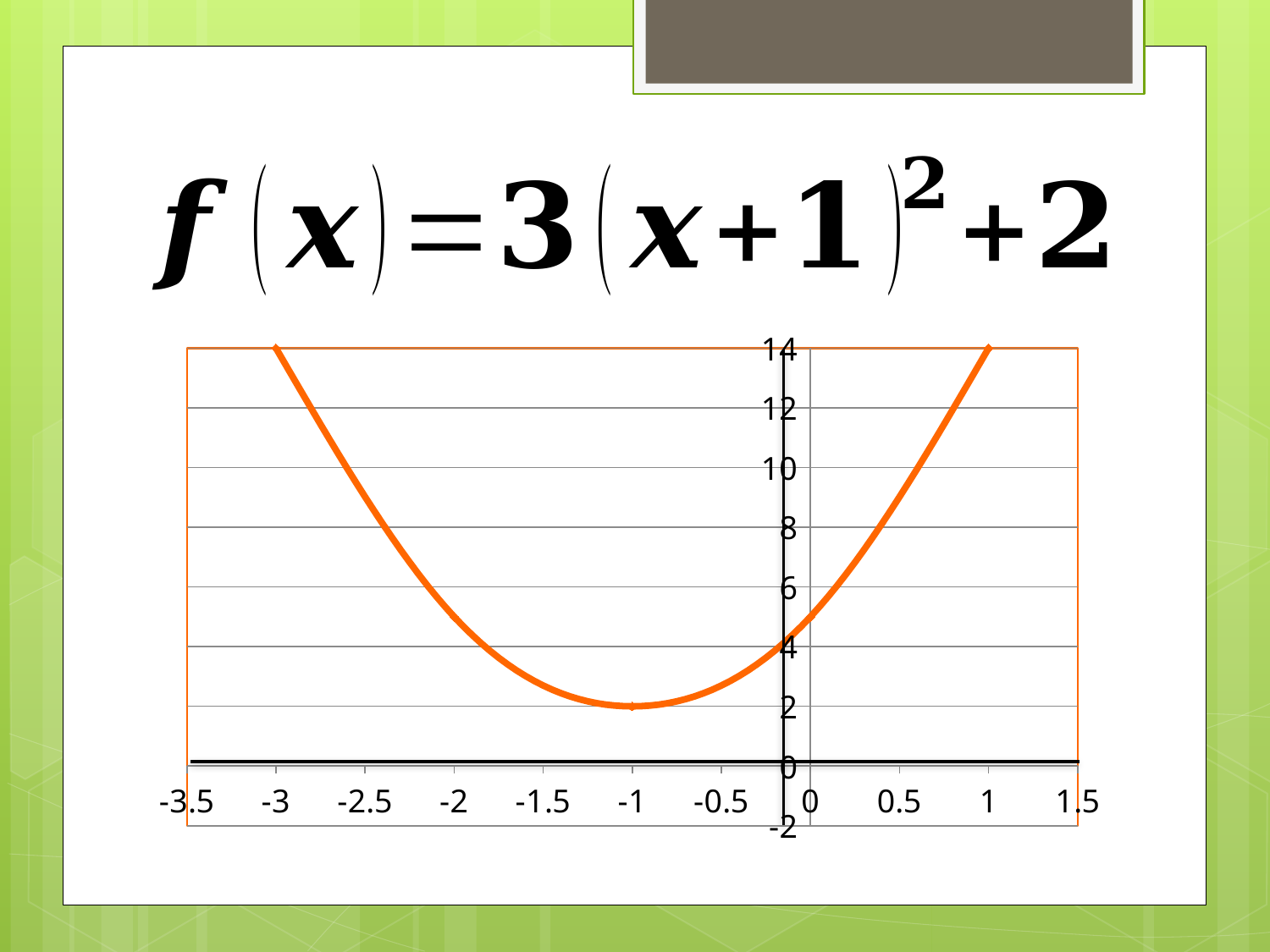
At which x value does the plotted curve reach its lowest point? -1 What is the value of the curve at x = -3? 14 What is the value of the curve at x = -1? 2 Is the value of the curve at x = -2 greater or less than 8? less What kind of chart is shown on the slide? line chart Which is larger: the value of the curve at x = -2 or at x = -1? x = -2 Does the curve rise or fall as x goes from -3 to -1? fall Does the curve rise or fall as x goes from -1 to 1? rise What is the value of the curve at x = 1? 14 Is the value of the curve at x = 0 greater or less than 6? less What function is written above the chart? f(x) = 3(x+1)^2 + 2 Is the value of the curve at x = 0 greater or less than 4? greater